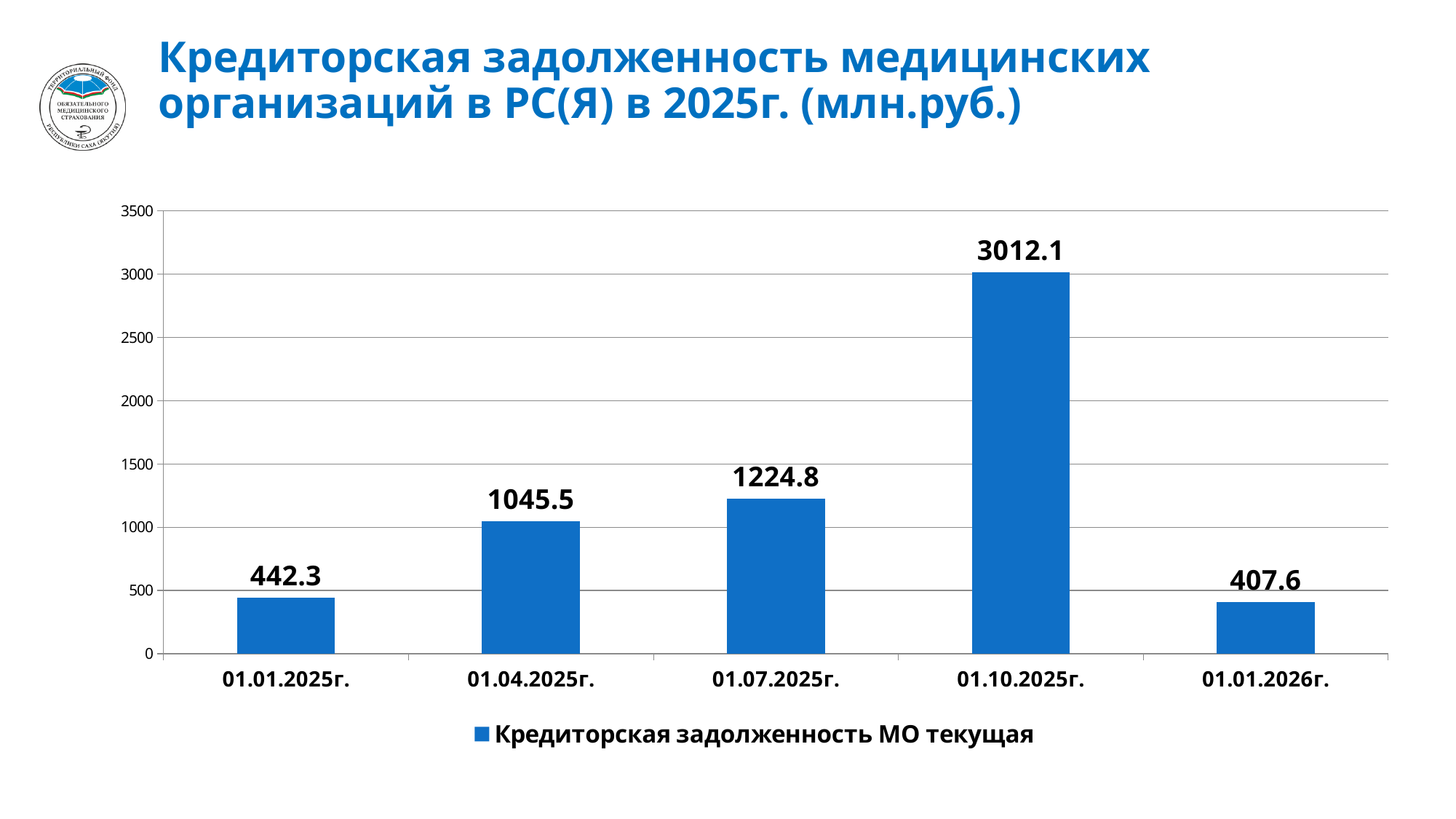
How many series does the legend list? 1 Which is larger, the value for 01.01.2025г. or 01.01.2026г.? 01.01.2025г. What is the value for 01.01.2025г.? 442.3 How many dates are shown on the x axis? 5 Is the value for 01.10.2025г. greater or less than 3000? greater Which date has the lowest value? 01.01.2026г. What is the difference between the values for 01.07.2025г. and 01.04.2025г.? 179.3 What is the value for 01.10.2025г.? 3012.1 What is the value for 01.01.2026г.? 407.6 What is the legend entry for the series? Кредиторская задолженность МО текущая What kind of chart is shown? bar chart Which date has the highest value? 01.10.2025г.